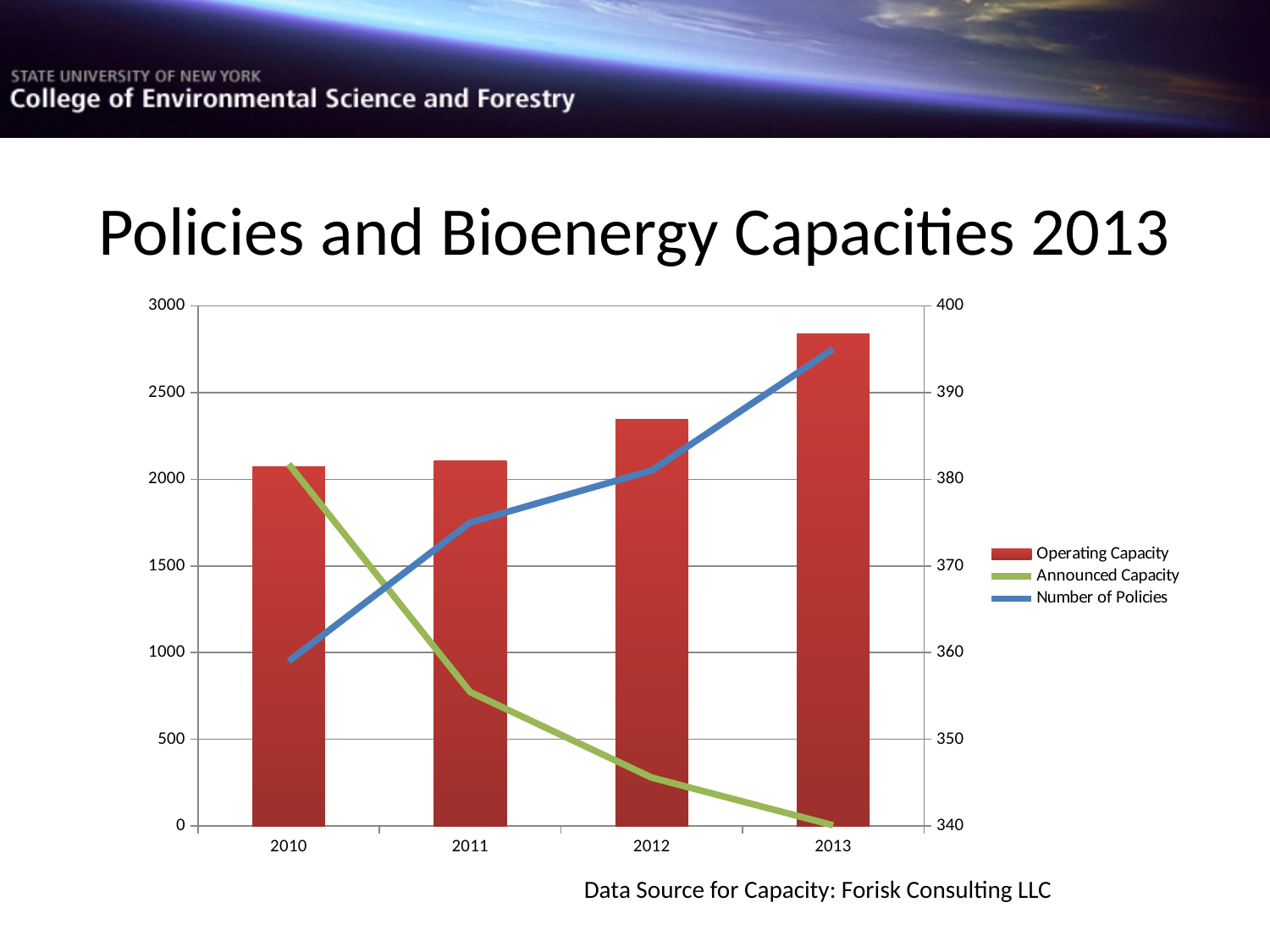
What kind of chart is shown on the slide? A combined bar and line chart Is the Operating Capacity for 2012 greater or less than 2500? less Which year has the lowest Announced Capacity? 2013 Is the Number of Policies for 2011 greater or less than 370? greater Is the Announced Capacity for 2011 greater or less than 1000? less Does the Announced Capacity rise or fall from 2010 to 2013? fall How many years are shown on the x axis? 4 Which series is plotted as bars? Operating Capacity How many series does the legend list? 3 Which year has the highest Operating Capacity? 2013 Which year has the highest Number of Policies? 2013